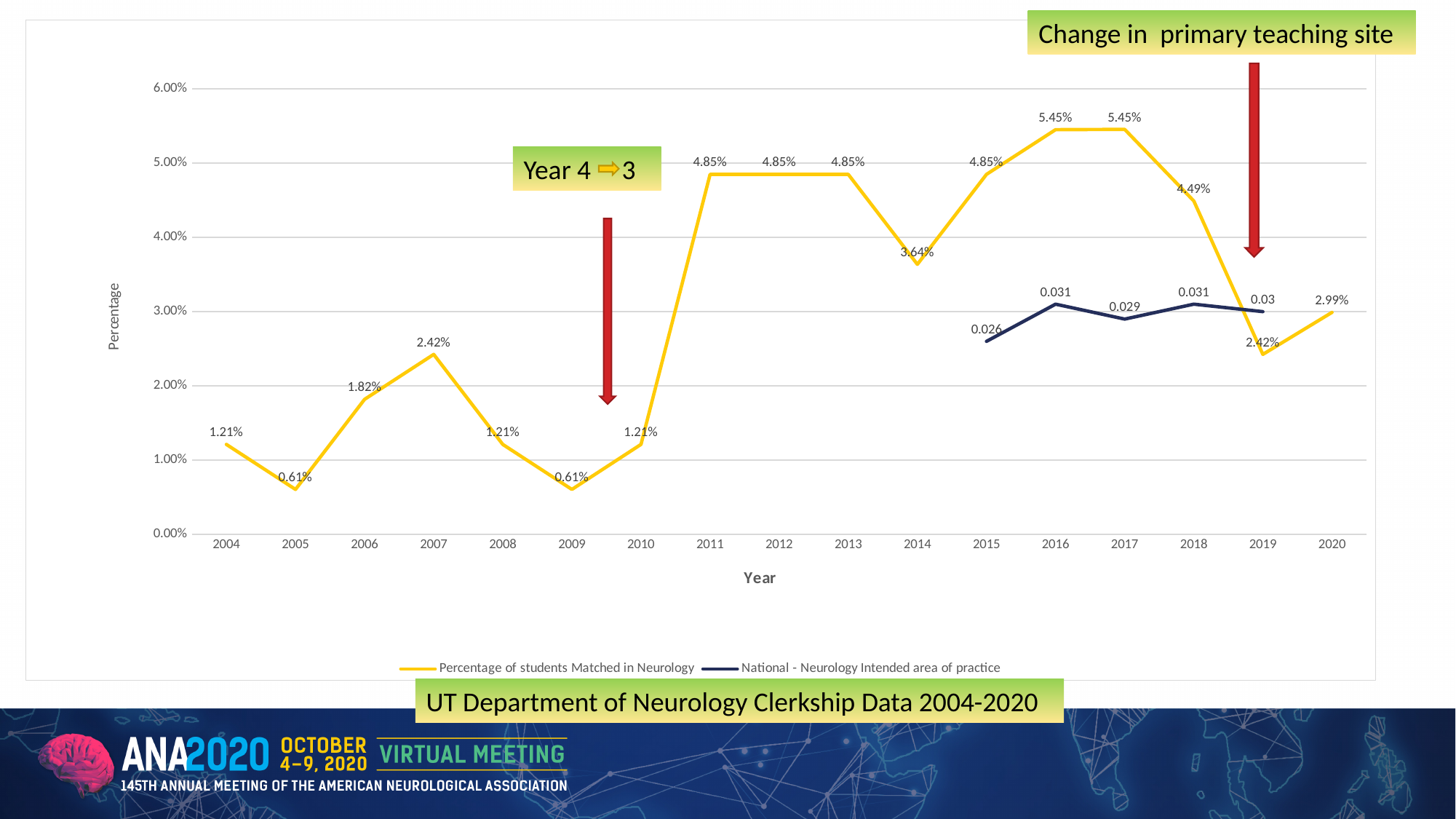
What is the difference in the Percentage of students Matched in Neurology between 2010 and 2011? 3.64% Which year has a higher Percentage of students Matched in Neurology, 2014 or 2015? 2015 How many series does the legend list? 2 What is the highest value reached by the Percentage of students Matched in Neurology series? 5.45% What is the Percentage of students Matched in Neurology in 2007? 2.42% What is the value of the National - Neurology Intended area of practice series in 2015? 0.026 How many years are shown on the x axis? 17 What kind of chart is shown on the slide? Line chart What is the value of the National - Neurology Intended area of practice series in 2017? 0.029 What is the Percentage of students Matched in Neurology in 2020? 2.99% By how much did the Percentage of students Matched in Neurology drop from 2018 to 2019? 2.07% What is the lowest value of the Percentage of students Matched in Neurology series? 0.61%